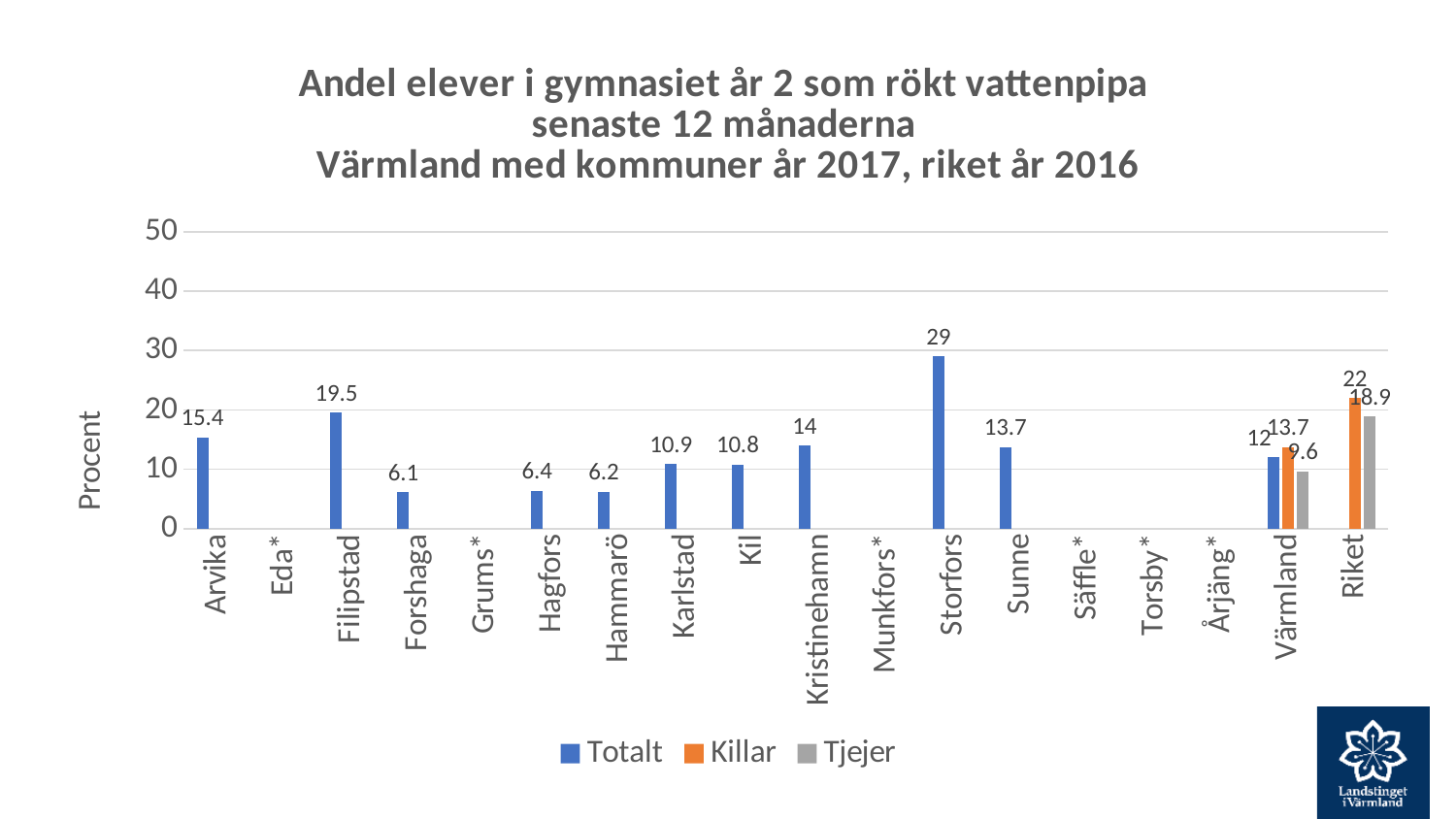
What is the Totalt value for Storfors? 29 Among the categories with a plotted Totalt bar, which has the lowest value? Forshaga What is the difference between the Killar and Tjejer values for Värmland? 4.1 What is the difference between the Totalt values for Storfors and Filipstad? 9.5 What is the Tjejer value for Riket? 18.9 What is the Killar value for Värmland? 13.7 How many series does the legend list? 3 Which has a higher Totalt value, Arvika or Sunne? Arvika What is the label on the vertical axis? Procent What kind of chart is shown on the slide? Bar chart Which category has the highest Totalt value? Storfors What is the Totalt value for Filipstad? 19.5